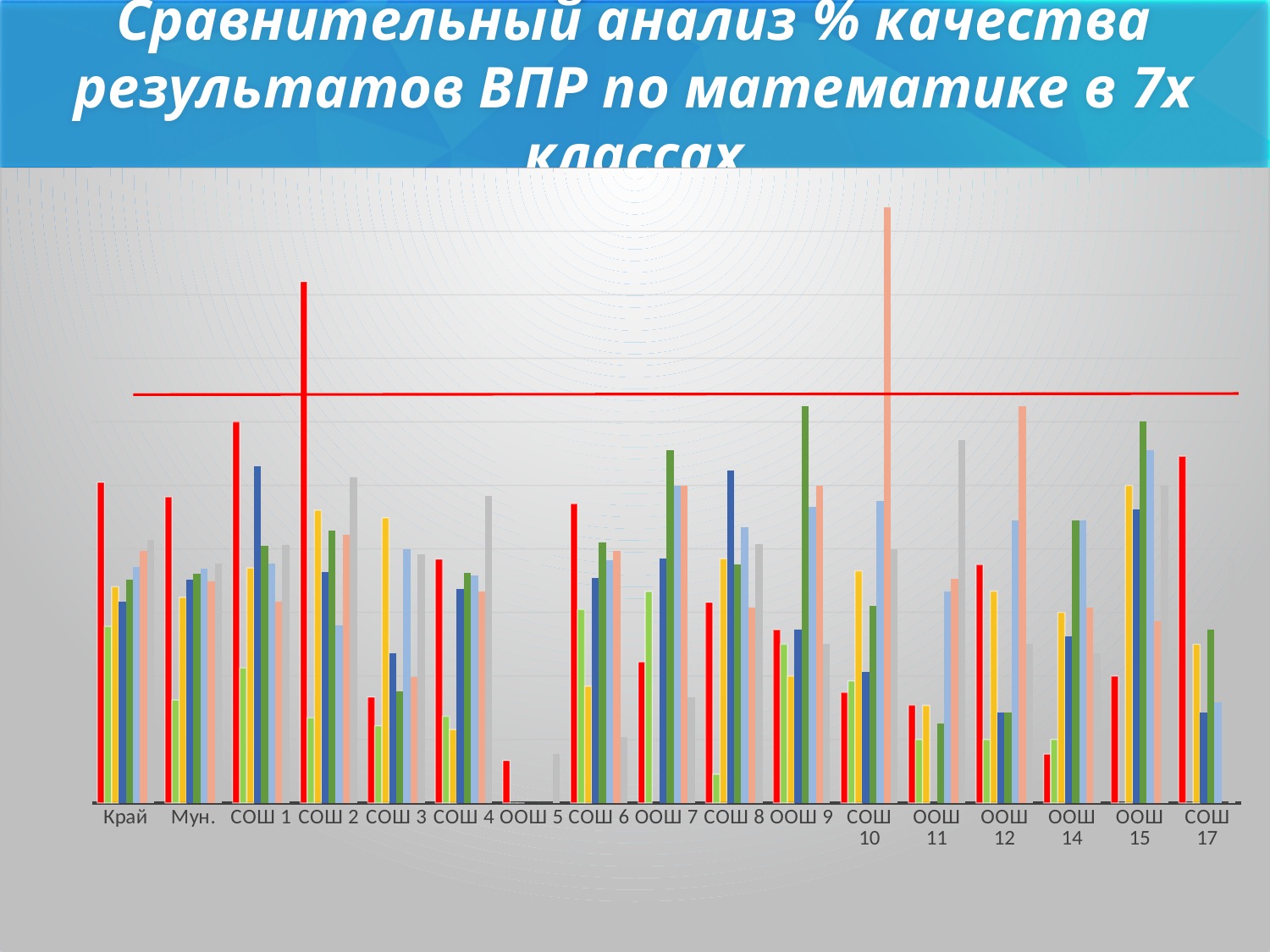
Which category contains the single tallest bar in the whole chart? СОШ 10 What kind of chart is shown on the slide? Bar chart Is the red bar for СОШ 1 taller or shorter than the red bar for ООШ 11? Taller Which category has the shortest red bar in the chart? ООШ 5 What is the last category on the x axis of the chart? СОШ 17 Does the chart display a legend identifying the series? No Is the red bar for ООШ 14 taller or shorter than the red bar for СОШ 17? Shorter What is the first category on the x axis of the chart? Край Which category has the tallest red bar in the chart? СОШ 2 Is the red bar for Край taller or shorter than the red bar for Мун.? Taller How many categories are shown along the x axis of the chart? 17